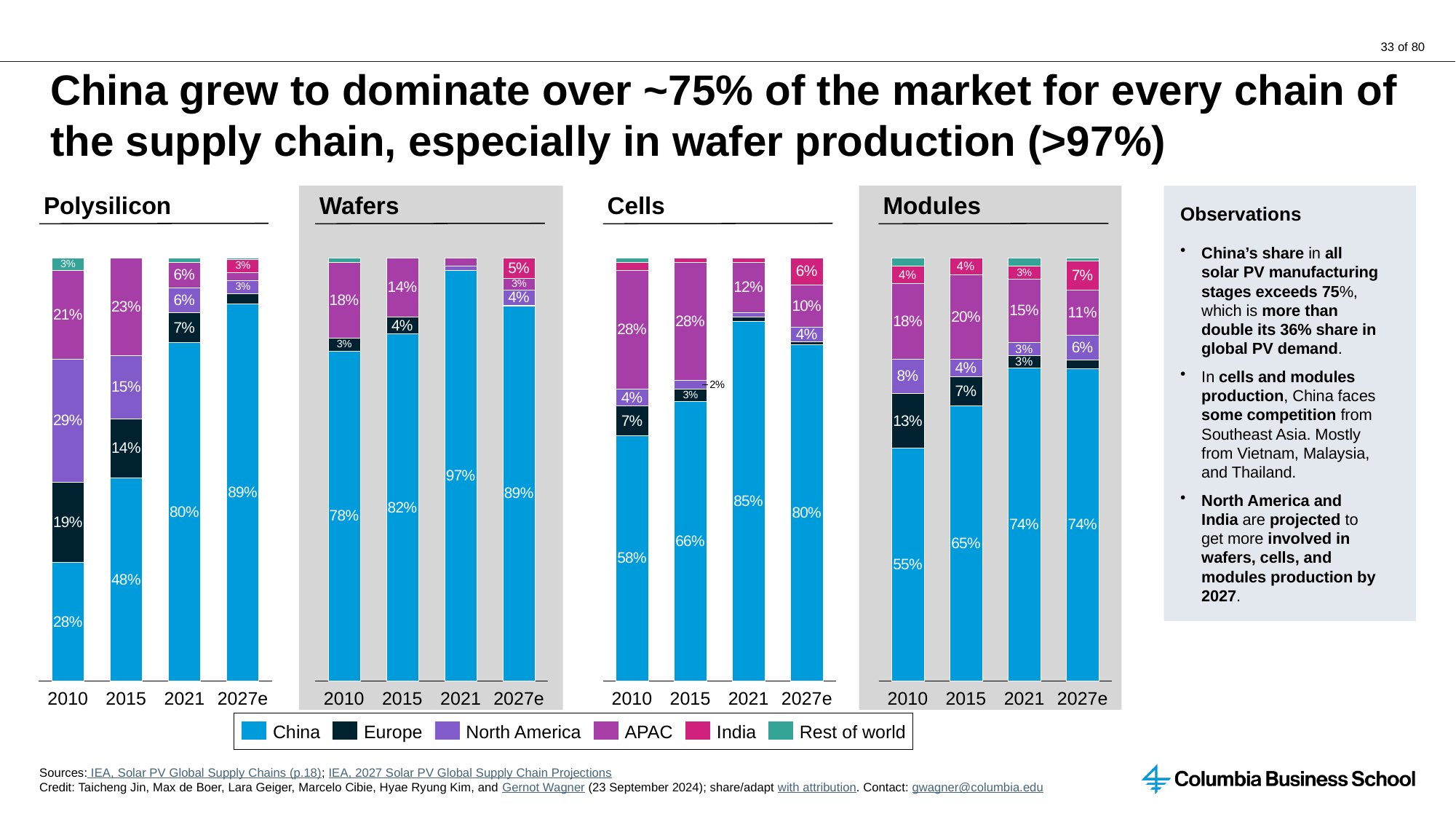
In the Wafers chart, which is larger: APAC's share in 2010 or in 2015? 2010 In the Polysilicon chart, in which year is China's share the lowest? 2010 How many years are shown on the x axis of the Polysilicon chart? 4 In the Cells chart, in which year is China's share the highest? 2021 In the Wafers chart, does China's share rise or fall from 2010 to 2021? Rise In the Wafers chart, what is China's share in 2021? 97% In the Modules chart, what is the difference between China's share in 2021 and in 2010? 19% In the Polysilicon chart, what is North America's share in 2010? 29% In the Modules chart, what is Europe's share in 2010? 13% What kind of chart is used for the Cells data? Stacked bar chart In the Cells chart, what is APAC's share in 2015? 28% How many regions does the legend list? 6